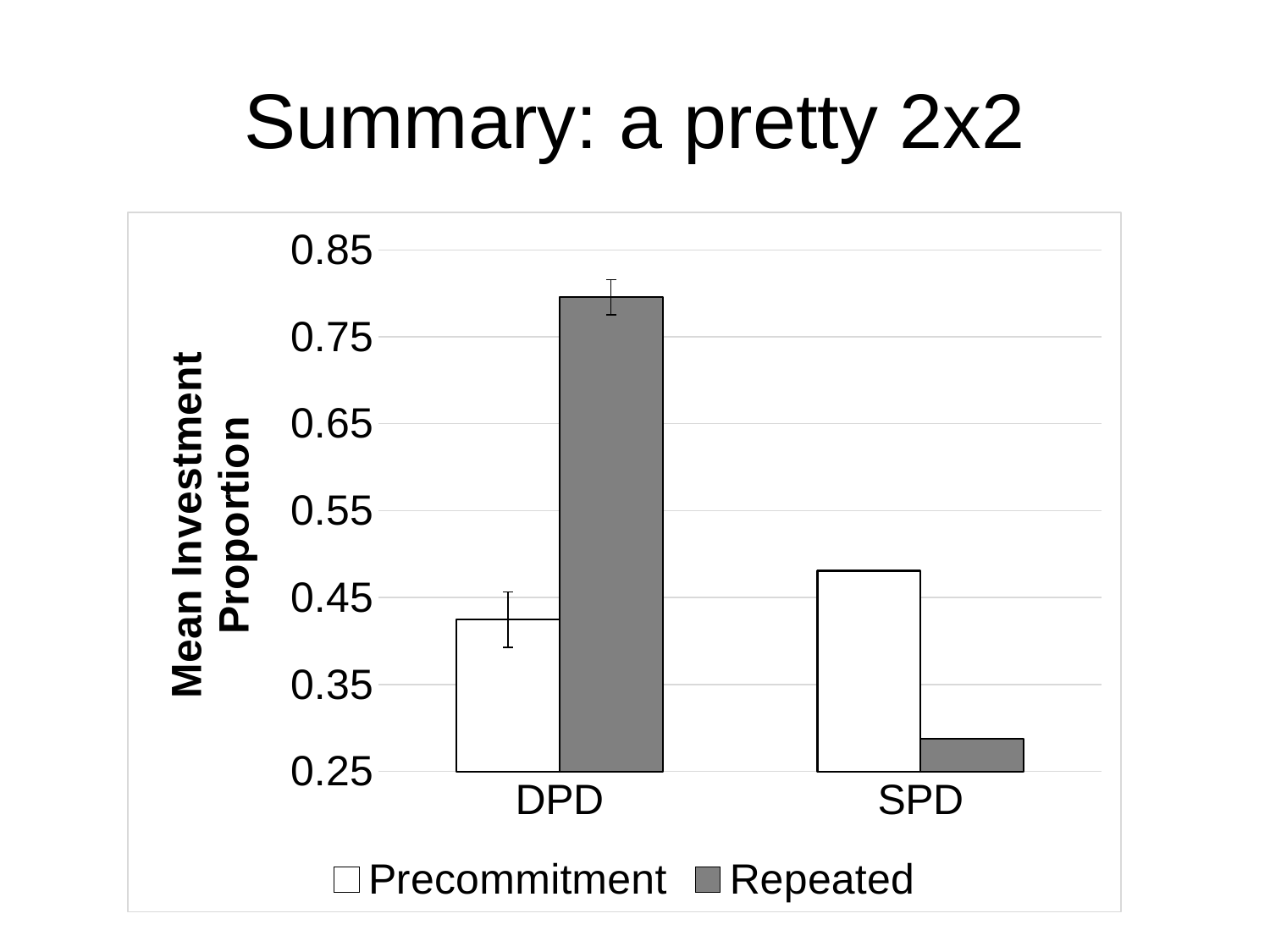
What is the title of the y axis? Mean Investment Proportion Is the Repeated value for DPD greater or less than 0.75? greater Is the Precommitment value for SPD greater or less than 0.45? greater Is the Repeated value for SPD greater or less than 0.35? less For SPD, which is larger: Precommitment or Repeated? Precommitment For DPD, which is larger: Precommitment or Repeated? Repeated Which bar is the shortest in the chart? Repeated for SPD What kind of chart is shown on the slide? bar chart How many categories are shown on the x axis? 2 How many series does the legend list? 2 Which bar is the tallest in the chart? Repeated for DPD